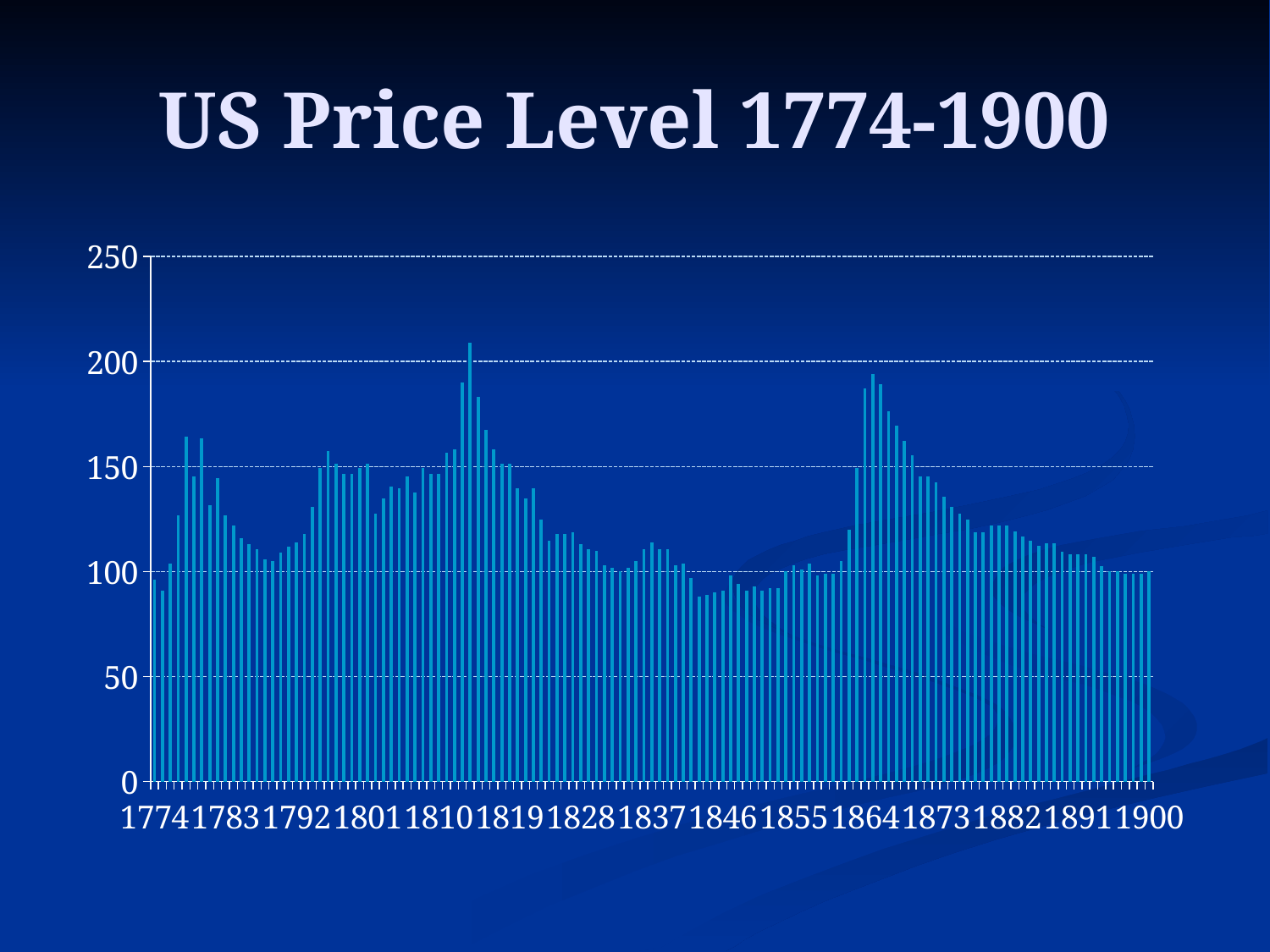
Is the value for 1783 greater or less than 150? less Is the value for 1846 greater or less than 150? less Is the value for 1837 greater or less than 150? less Do the values generally rise or fall from 1864 to 1900? fall What is the title of the chart? US Price Level 1774-1900 Which is larger, the value for 1864 or the value for 1837? 1864 What is the highest value shown on the vertical axis? 250 What kind of chart is shown on the slide? bar chart Which is larger, the value for 1783 or the value for 1846? 1783